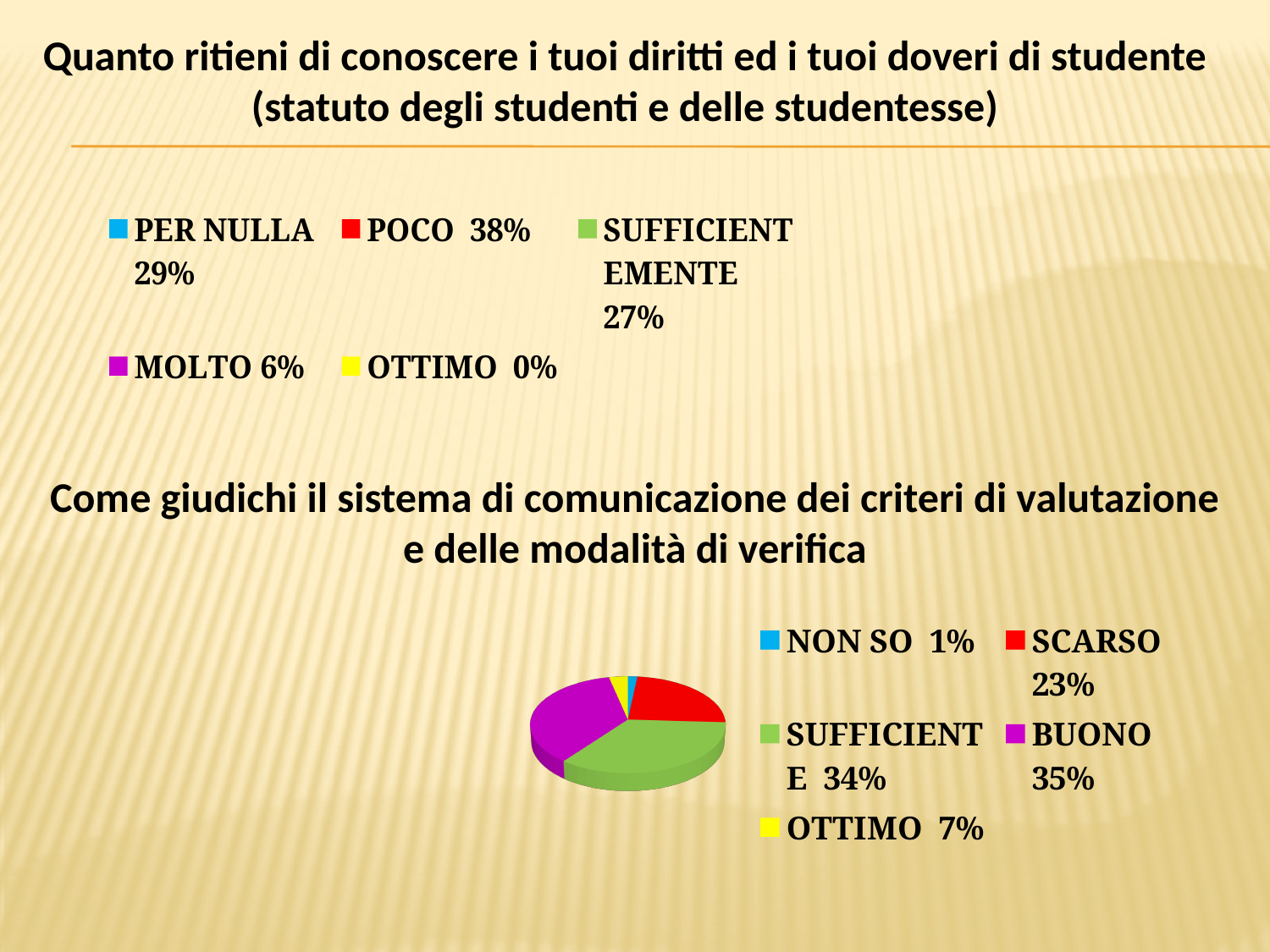
In the chart titled "Quanto ritieni di conoscere i tuoi diritti ed i tuoi doveri di studente", which is larger, PER NULLA or SUFFICIENTEMENTE? PER NULLA In the chart titled "Quanto ritieni di conoscere i tuoi diritti ed i tuoi doveri di studente", what percentage is shown for MOLTO? 6% In the chart titled "Quanto ritieni di conoscere i tuoi diritti ed i tuoi doveri di studente", what percentage is shown for POCO? 38% In the chart titled "Come giudichi il sistema di comunicazione dei criteri di valutazione e delle modalità di verifica", what is the difference in percentage points between SUFFICIENTE and SCARSO? 11 In the chart titled "Come giudichi il sistema di comunicazione dei criteri di valutazione e delle modalità di verifica", which category has the smallest share? NON SO In the chart titled "Come giudichi il sistema di comunicazione dei criteri di valutazione e delle modalità di verifica", what kind of chart is shown? pie chart In the chart titled "Quanto ritieni di conoscere i tuoi diritti ed i tuoi doveri di studente", how many categories does the legend list? 5 In the chart titled "Come giudichi il sistema di comunicazione dei criteri di valutazione e delle modalità di verifica", what percentage is shown for OTTIMO? 7% In the chart titled "Come giudichi il sistema di comunicazione dei criteri di valutazione e delle modalità di verifica", which category has the largest share? BUONO In the chart titled "Come giudichi il sistema di comunicazione dei criteri di valutazione e delle modalità di verifica", what percentage is shown for SCARSO? 23% In the chart titled "Come giudichi il sistema di comunicazione dei criteri di valutazione e delle modalità di verifica", what colour represents BUONO? purple In the chart titled "Come giudichi il sistema di comunicazione dei criteri di valutazione e delle modalità di verifica", how many categories does the legend list? 5